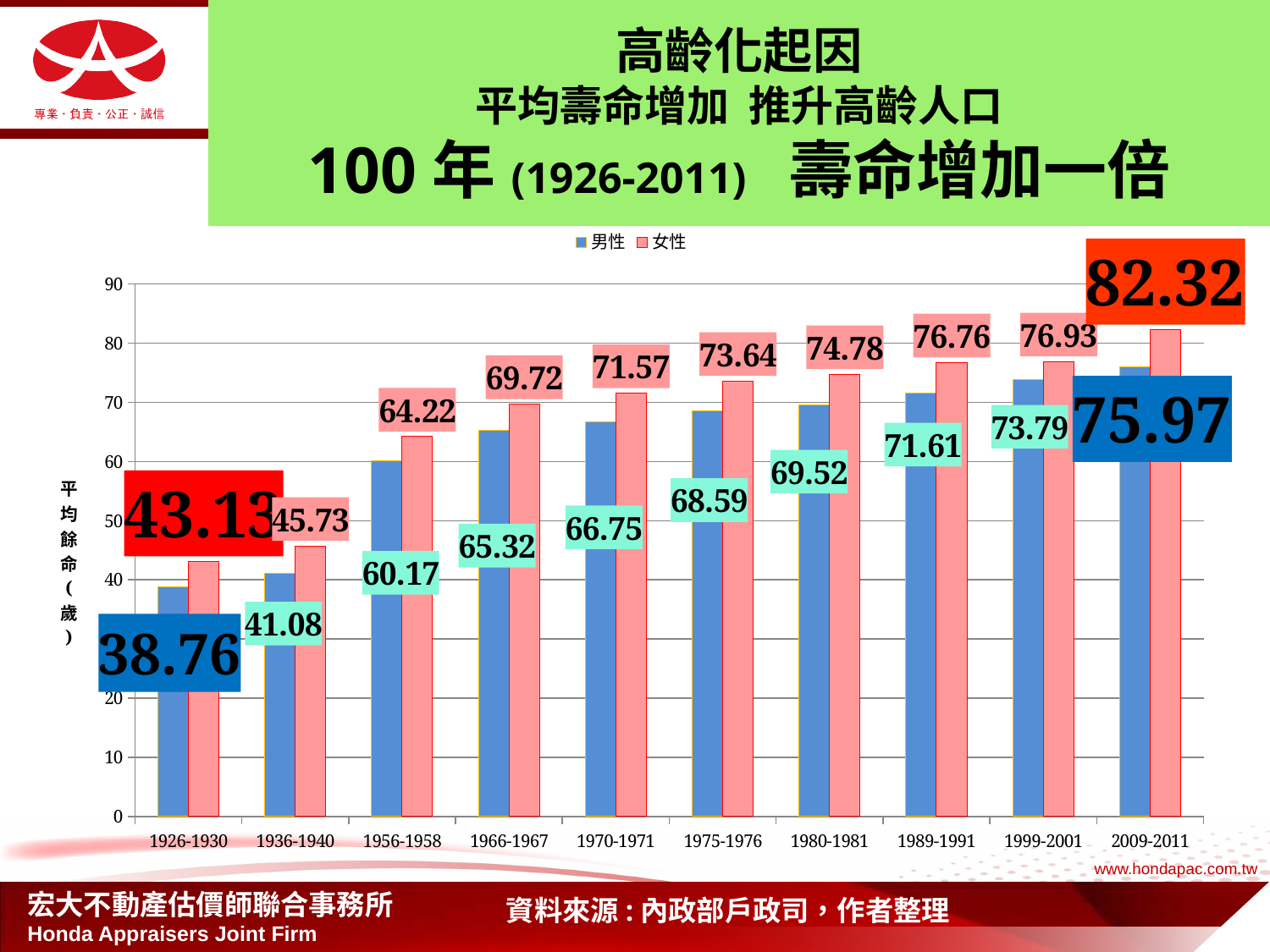
What is the value for 男性 in 1956-1958? 60.17 Which is larger in 1999-2001, the 男性 value or the 女性 value? 女性 Do the 男性 values rise or fall from 1926-1930 to 2009-2011? rise What is the value for 女性 in 2009-2011? 82.32 How many series does the legend list? 2 What kind of chart is shown on the slide? bar chart What is the difference between the 女性 and 男性 values in 2009-2011? 6.35 How many periods are shown on the x axis? 10 Which period has the lowest value for 男性? 1926-1930 Which period has the highest value for 女性? 2009-2011 What is the value for 女性 in 1980-1981? 74.78 What is the value for 男性 in 1926-1930? 38.76